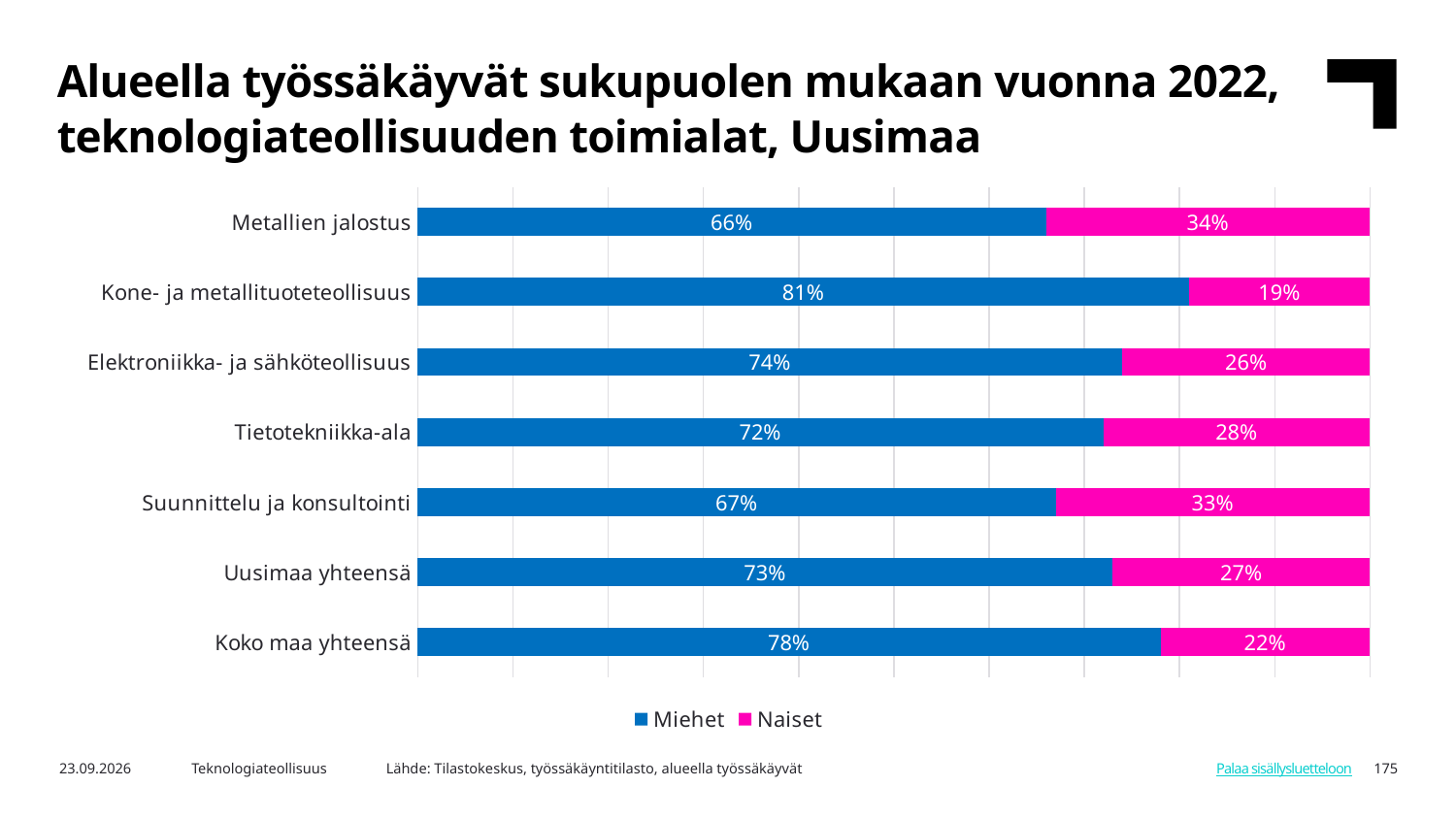
Which category has the lowest Miehet share? Metallien jalostus What is the total of the stacked bar for Tietotekniikka-ala? 100% How many categories are shown on the chart? 7 How many series does the legend list? 2 What is the Naiset share for Kone- ja metallituoteteollisuus? 19% What kind of chart is shown on the slide? Stacked bar chart What is the Naiset share for Tietotekniikka-ala? 28% What is the Miehet share for Koko maa yhteensä? 78% Which is larger: the Naiset share for Elektroniikka- ja sähköteollisuus or for Uusimaa yhteensä? Uusimaa yhteensä What is the difference between the Miehet and Naiset shares for Suunnittelu ja konsultointi? 34 percentage points What is the Miehet share for Metallien jalostus? 66% Which category has the highest Miehet share? Kone- ja metallituoteteollisuus